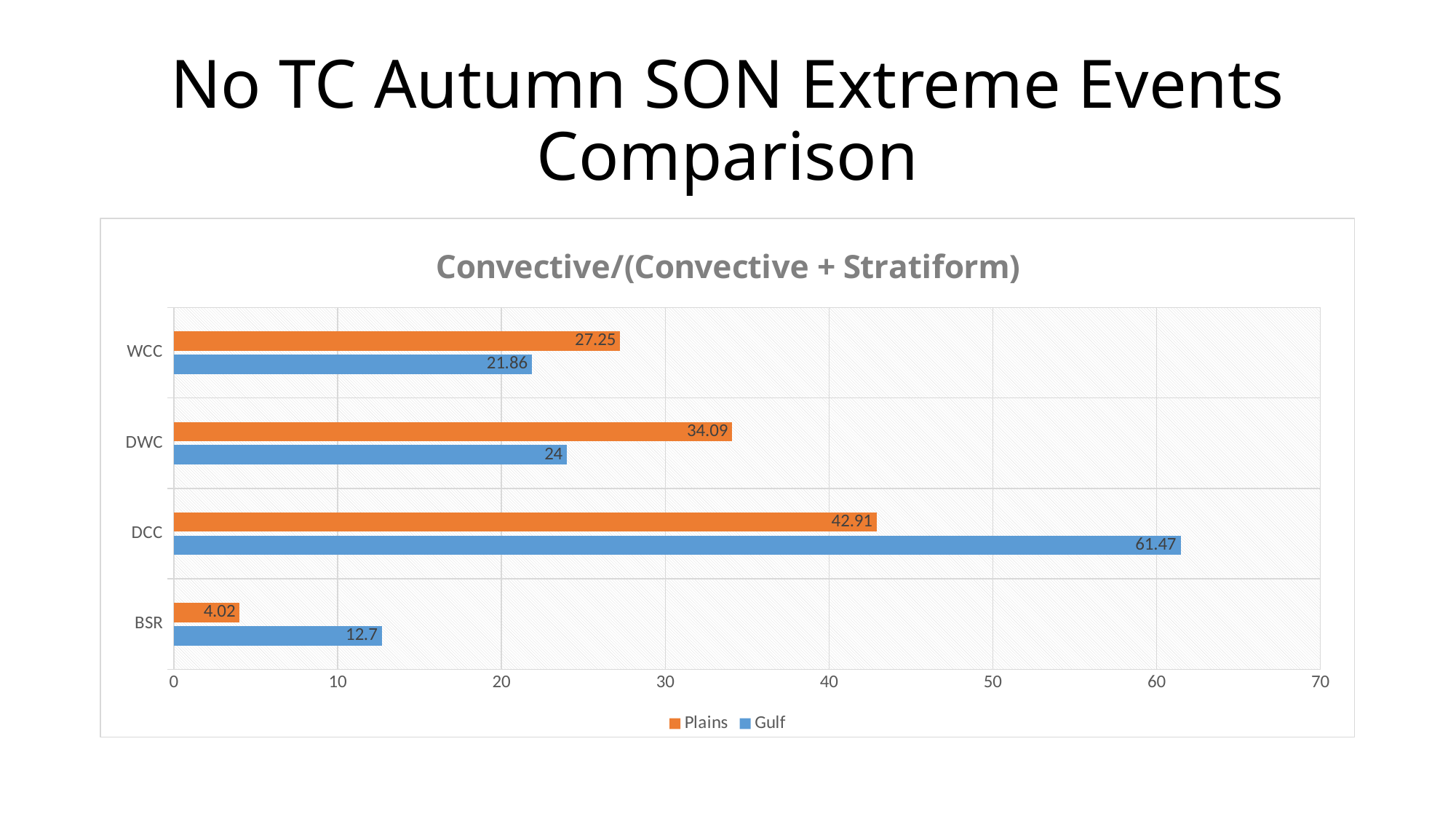
What kind of chart is shown? Bar chart Which category has the lowest Plains value? BSR What is the Gulf value for BSR? 12.7 What is the title of the chart? Convective/(Convective + Stratiform) What is the Gulf value for DWC? 24 Which category has the highest Gulf value? DCC What is the Plains value for WCC? 27.25 How many series does the legend list? 2 How many categories are shown on the chart? 4 For WCC, which is larger, the Plains value or the Gulf value? Plains What is the difference between the Gulf and Plains values for DCC? 18.56 What is the Plains value for DCC? 42.91